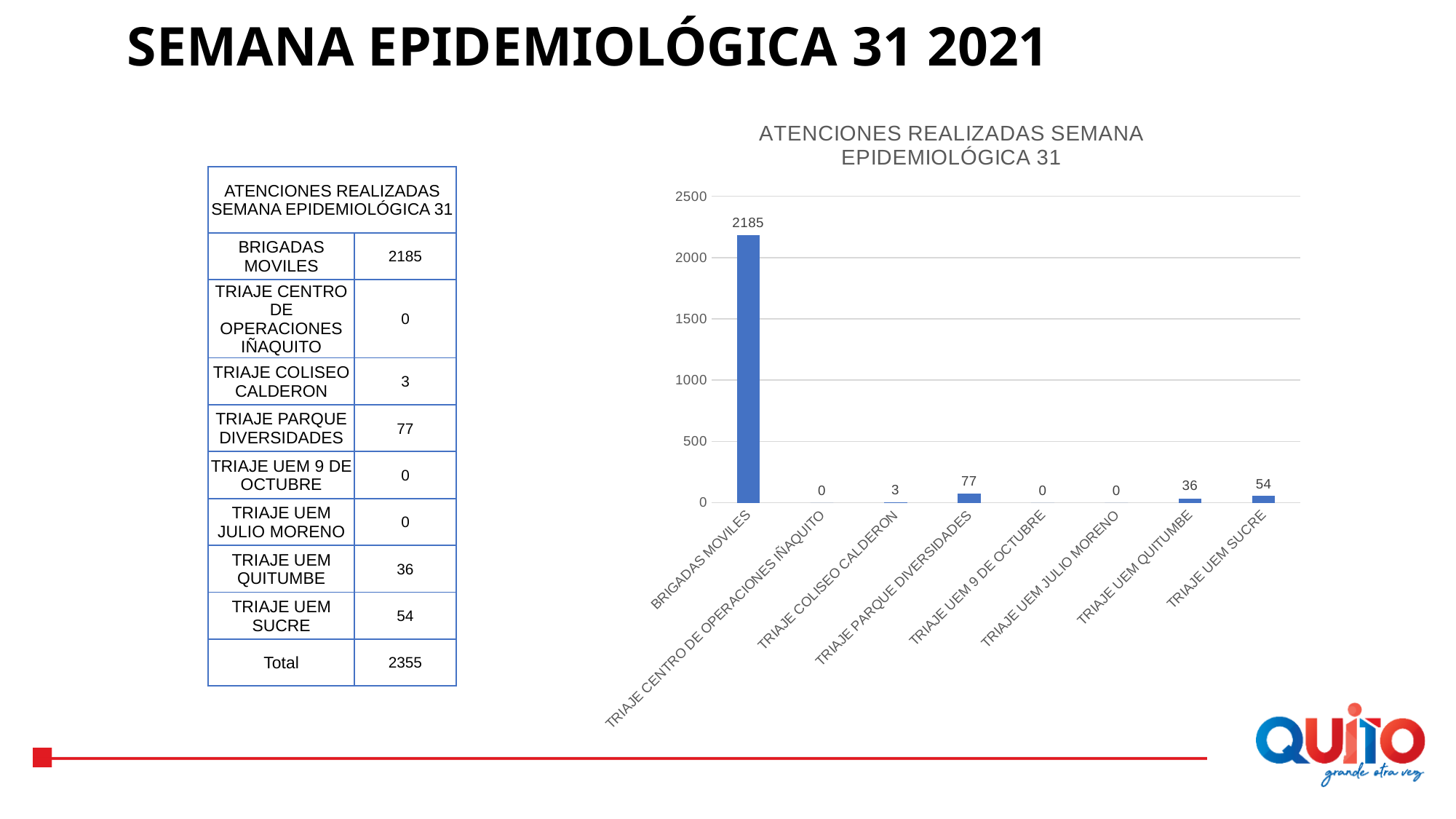
Which category has the highest value in the chart? BRIGADAS MOVILES How many categories are shown on the x axis of the chart? 8 What is the value for TRIAJE UEM SUCRE in the chart? 54 What is the value for TRIAJE PARQUE DIVERSIDADES in the chart? 77 What is the value for TRIAJE UEM QUITUMBE in the chart? 36 Is the value for BRIGADAS MOVILES greater or less than 2000? greater What is the difference between the values for BRIGADAS MOVILES and TRIAJE PARQUE DIVERSIDADES? 2108 What is the difference between the values for TRIAJE UEM SUCRE and TRIAJE UEM QUITUMBE? 18 Which is larger, the value for TRIAJE PARQUE DIVERSIDADES or TRIAJE UEM SUCRE? TRIAJE PARQUE DIVERSIDADES What type of chart is shown on the slide? bar chart What is the value for TRIAJE COLISEO CALDERON in the chart? 3 What is the value for BRIGADAS MOVILES in the chart? 2185